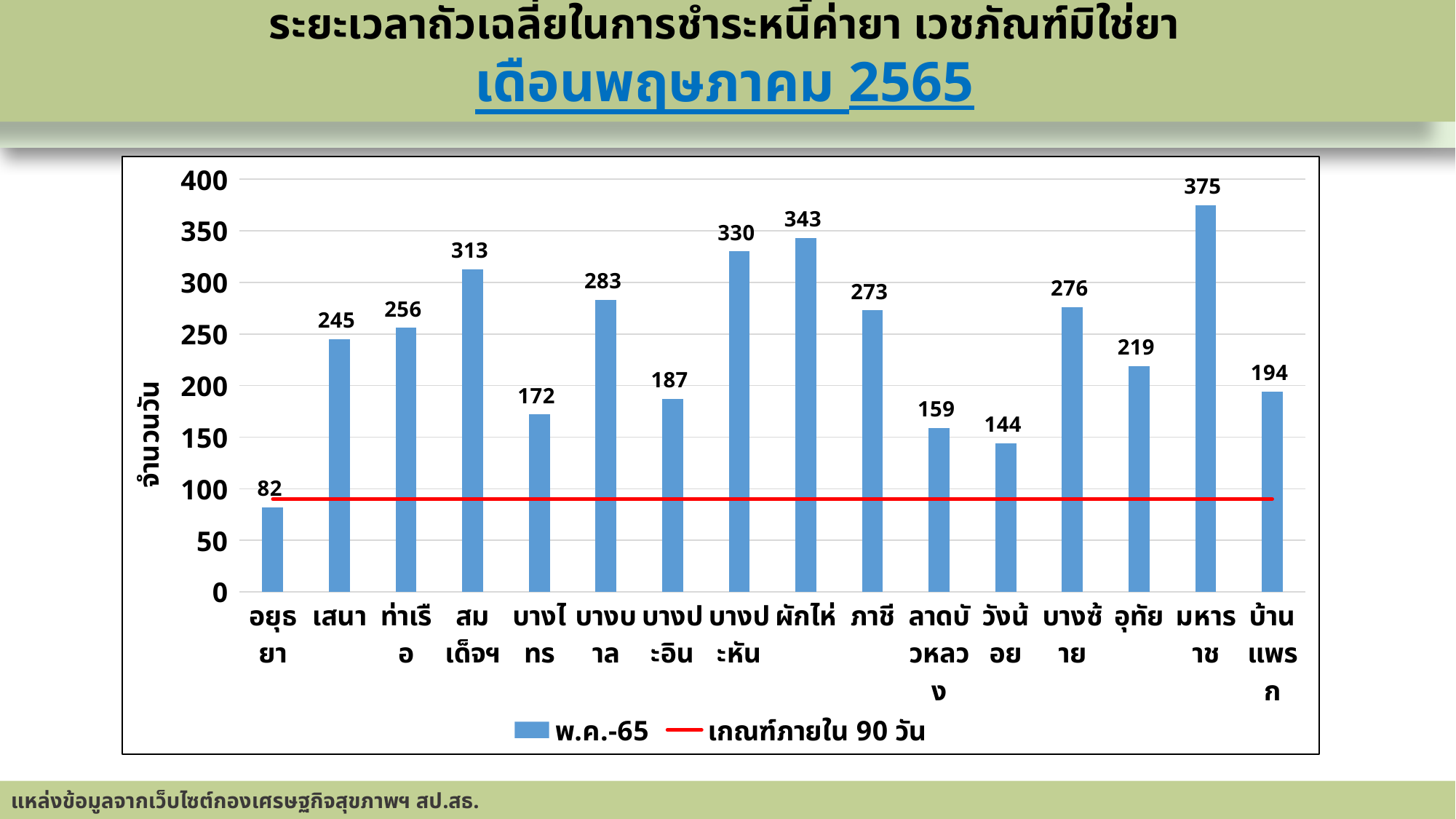
Which is larger, the value for วังน้อย or the value for อุทัย? อุทัย What kind of chart is shown on the slide? Combination bar and line chart What is the value for บางปะอิน? 187 What is the value for ลาดบัวหลวง? 159 What is the difference between the values for สมเด็จฯ and บางไทร? 141 Which is larger, the value for บางปะหัน or the value for บางบาล? บางปะหัน What is the difference between the values for มหาราช and อยุธยา? 293 How many entries does the legend list? 2 How many categories are shown on the x axis? 16 What is the value for ผักไห่? 343 Which category has the lowest value? อยุธยา Which category has the highest value? มหาราช